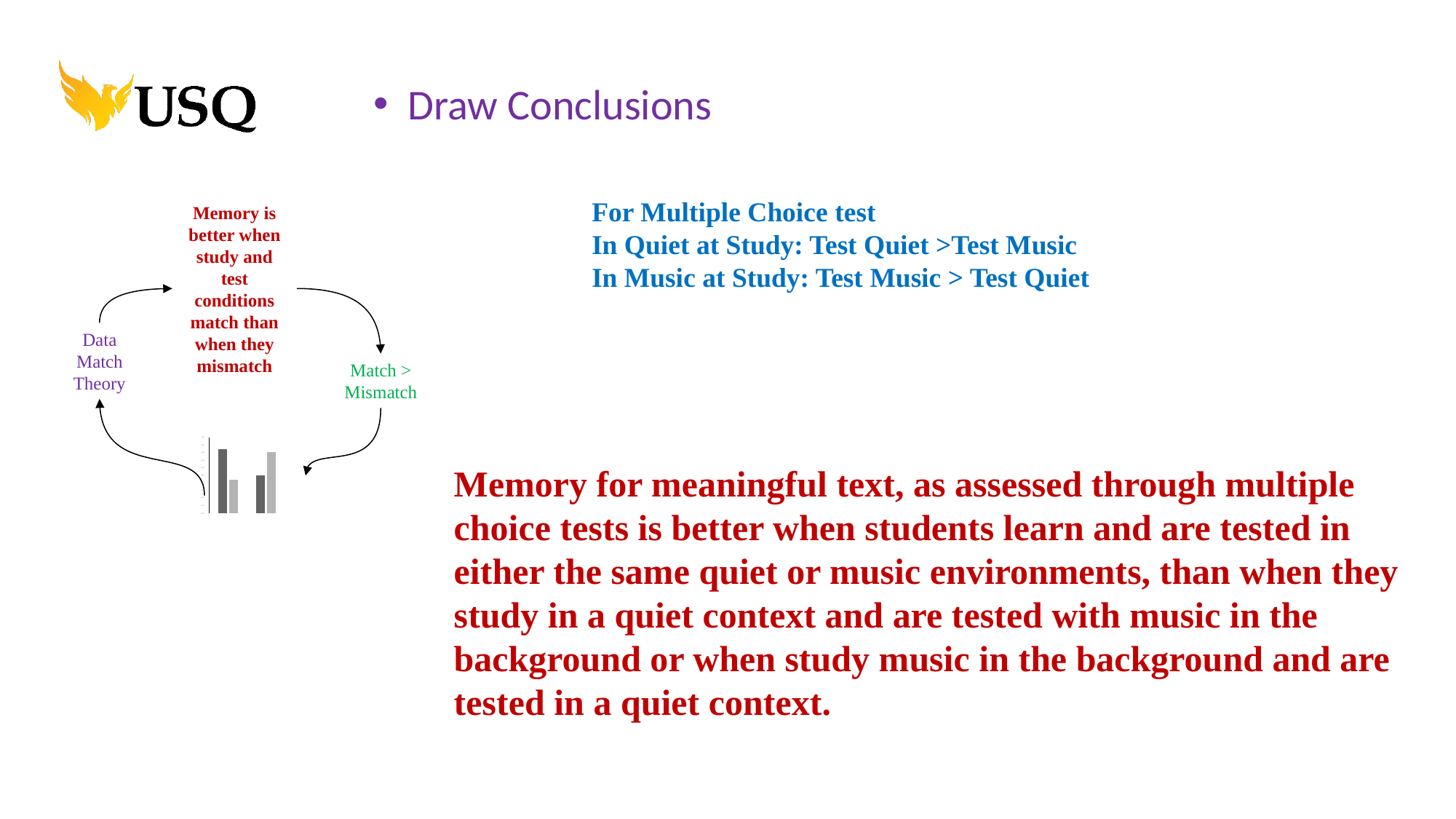
How many bars are plotted in the small chart at the bottom left of the slide? 4 In the small bar chart, in the left pair of bars, is the dark grey bar or the light grey bar taller? dark grey bar In the small bar chart, which bar is the tallest: the dark grey bar in the left pair, the light grey bar in the left pair, the dark grey bar in the right pair, or the light grey bar in the right pair? dark grey bar in the left pair What two colours are the bars in the small bar chart? dark grey and light grey In the small bar chart, in the right pair of bars, is the dark grey bar or the light grey bar taller? light grey bar What kind of chart is shown at the bottom left of the slide? bar chart How many groups of bars does the small bar chart show? 2 In the small bar chart, which bar is the shortest: the dark grey bar in the left pair, the light grey bar in the left pair, the dark grey bar in the right pair, or the light grey bar in the right pair? light grey bar in the left pair Does the small bar chart have a legend? No